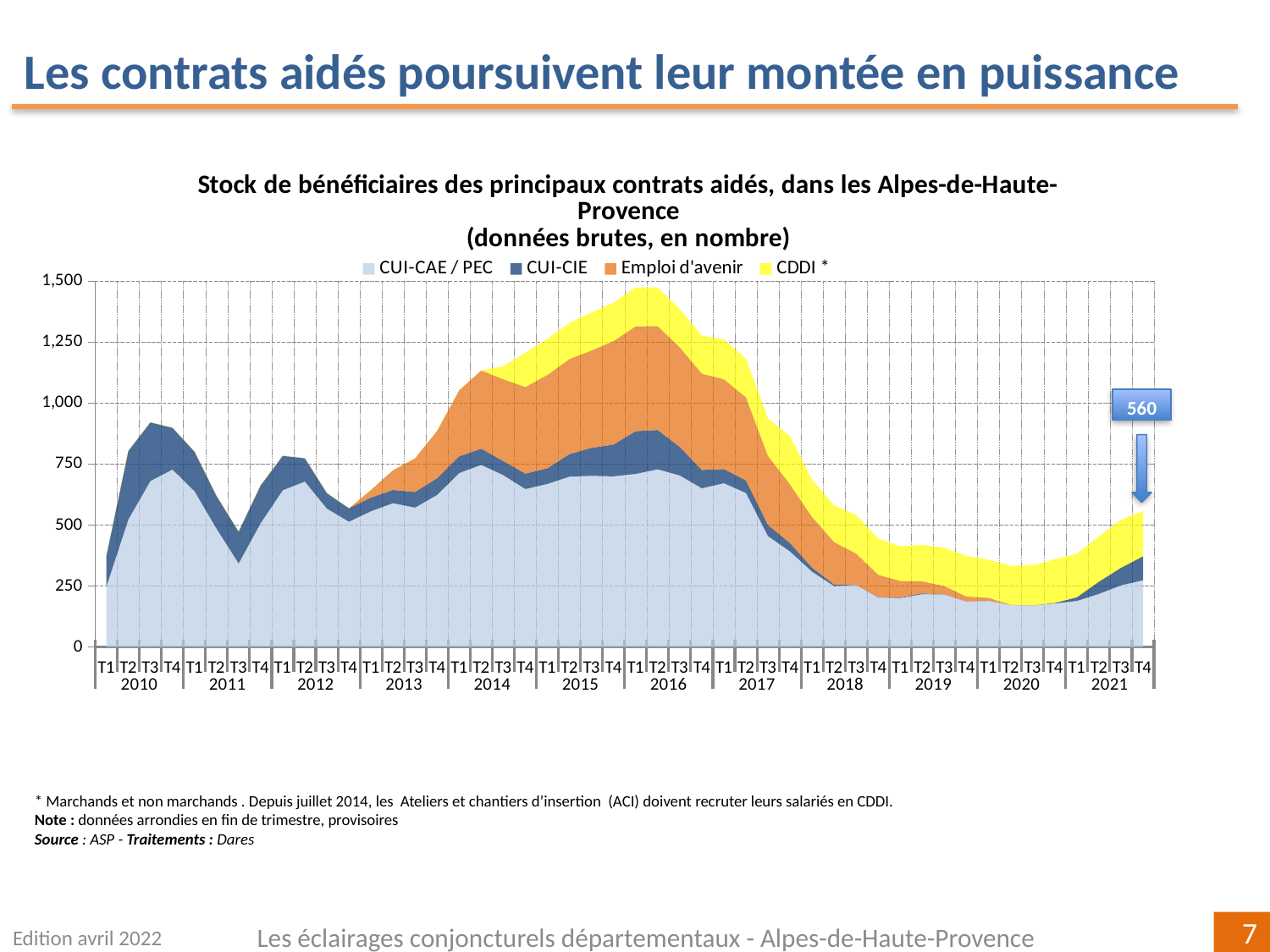
Between T1 2016 and T1 2020, does the total stock of beneficiaries rise or fall? fall How many years are shown on the x axis? 12 What is the first series listed in the legend? CUI-CAE / PEC Which is larger: the total at T2 2016 or the total at T4 2021? T2 2016 What kind of chart is shown on the slide? Stacked area chart Which series is shown in yellow? CDDI * Is the total stock of beneficiaries at T3 2020 greater or less than 500? less What total value is printed in the callout for T4 2021? 560 Is the total stock of beneficiaries at T1 2010 greater or less than 500? less Is the total stock of beneficiaries at T2 2016 greater or less than 1,250? greater How many series does the legend list? 4 In which year does the total stock of beneficiaries reach its highest peak? 2016